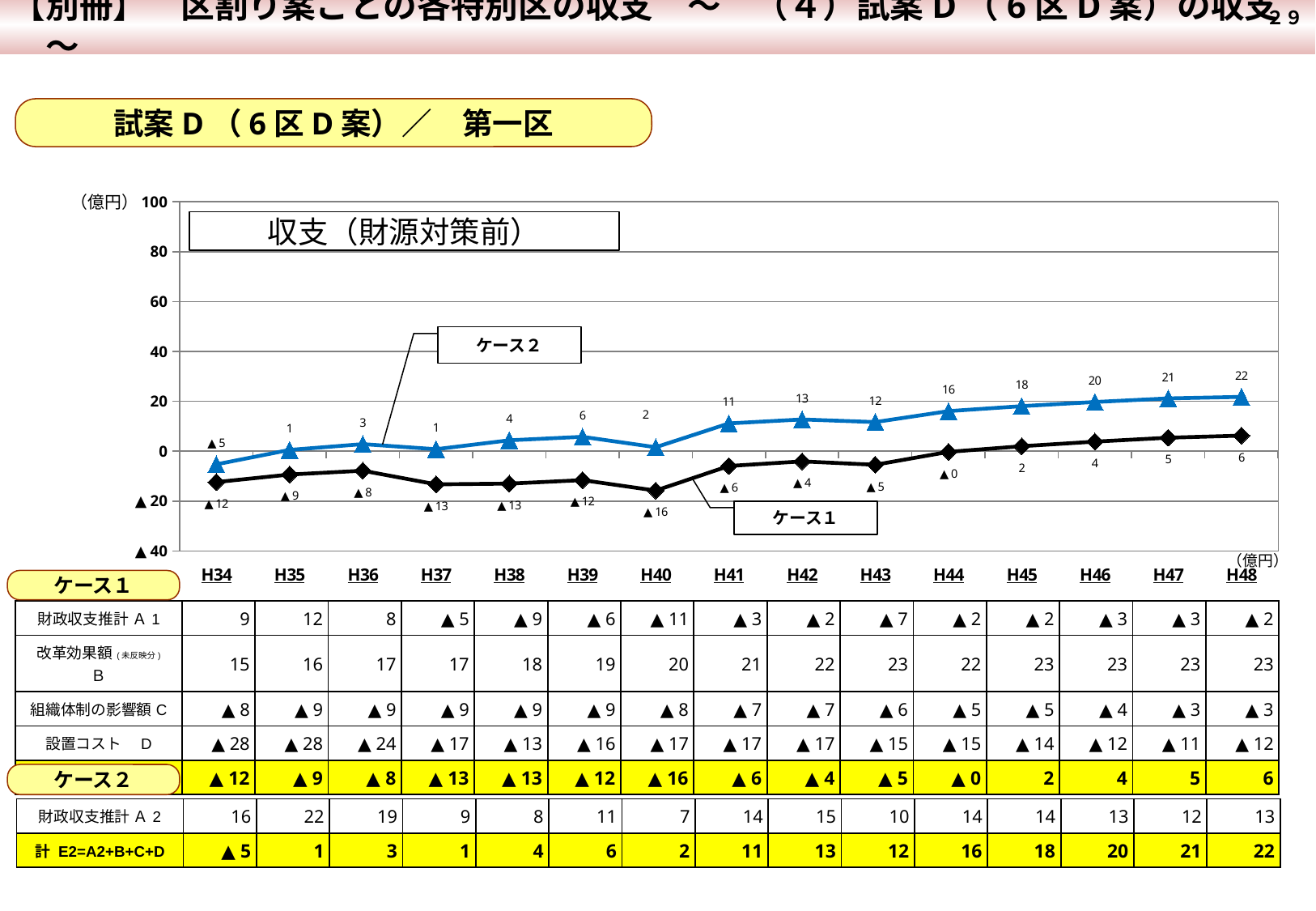
How many years (x-axis categories) are plotted in the chart? 15 How many series are plotted in the chart? 2 Does ケース2 generally rise or fall from H41 to H48? rise What is the value for ケース2 in H48? 22 In which year is ケース2 highest? H48 In which year is ケース1 lowest? H40 What is the value for ケース1 in H40? ▲16 What kind of chart is shown on the slide? line chart Which series has the larger value in H42, ケース1 or ケース2? ケース2 What is the difference between ケース2 and ケース1 in H48? 16 What is the chart's title? 収支（財源対策前） What is the value for ケース2 in H41? 11